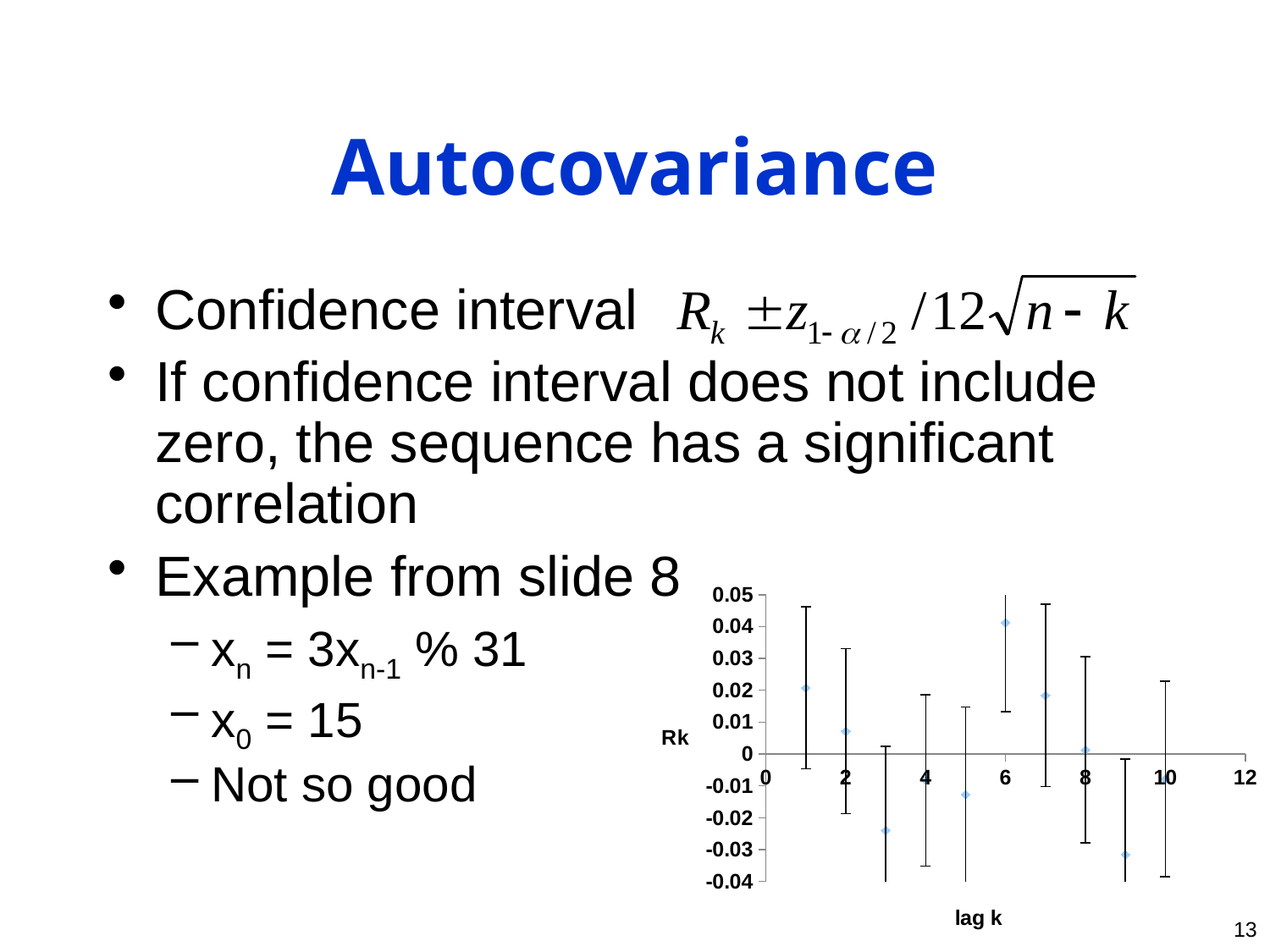
Is the Rk value at lag 1 greater or less than 0.01? greater Is the Rk value at lag 9 greater or less than -0.02? less How many data points are plotted in the chart? 10 What is the label of the x axis of the chart? lag k Is the Rk value at lag 6 greater or less than 0.03? greater Which has the larger Rk value, lag 6 or lag 7? lag 6 Which has the larger Rk value, lag 1 or lag 2? lag 1 At which lag k is the plotted Rk value highest? 6 What kind of chart is shown on the slide? scatter chart What is the label of the y axis of the chart? Rk At which lag k is the plotted Rk value lowest? 9